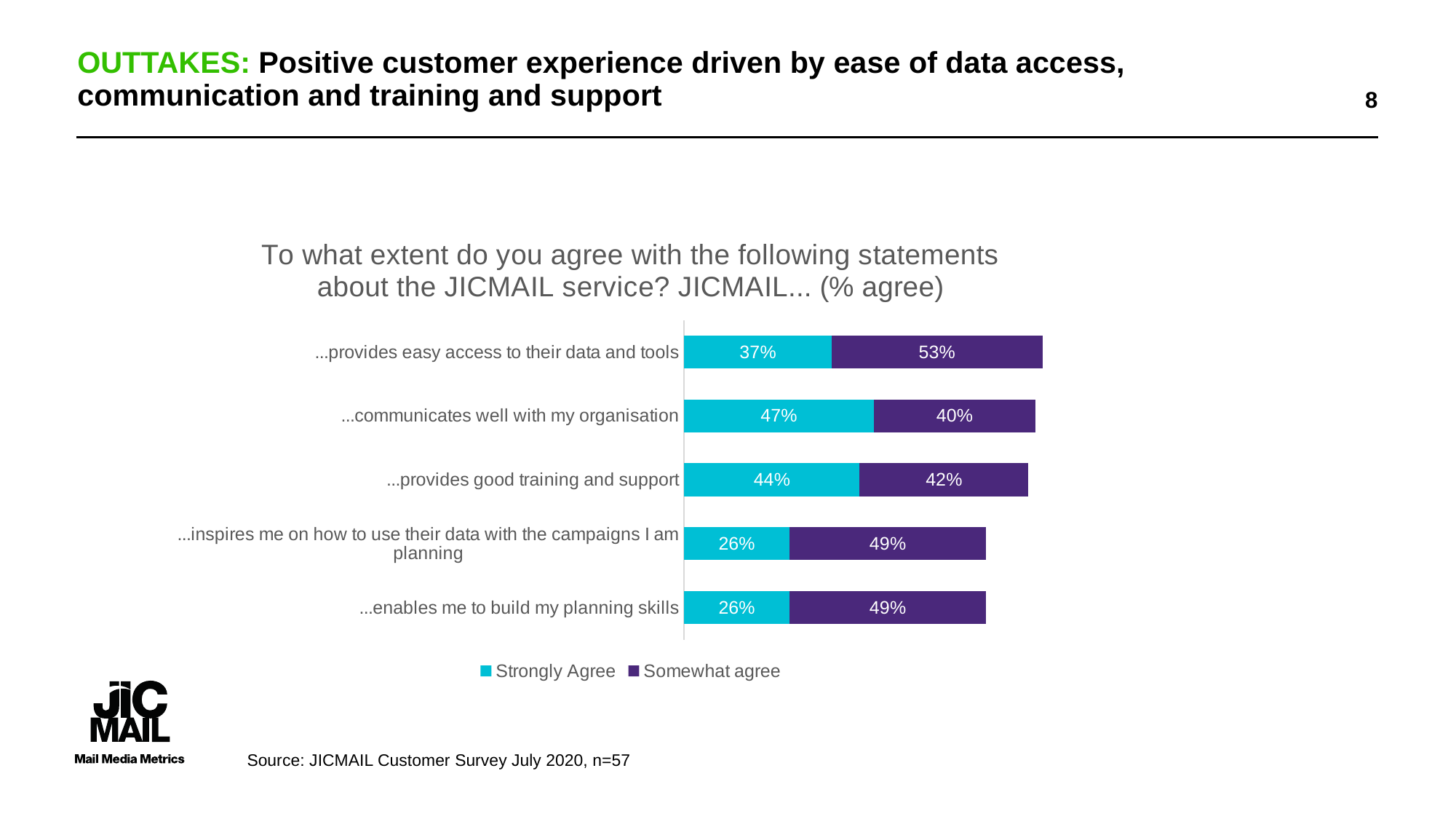
Which is larger: the Strongly Agree percentage for 'provides good training and support' or for 'provides easy access to their data and tools'? ...provides good training and support Which statement has the highest Strongly Agree percentage? ...communicates well with my organisation What is the total percentage agreeing (Strongly Agree plus Somewhat agree) that JICMAIL enables me to build my planning skills? 75% What is the total percentage agreeing (Strongly Agree plus Somewhat agree) that JICMAIL provides easy access to their data and tools? 90% How many statements are shown in the chart? 5 What is the difference between the Strongly Agree percentages for 'communicates well with my organisation' and 'enables me to build my planning skills'? 21 percentage points How many series does the legend list? 2 Which statement has the highest Somewhat agree percentage? ...provides easy access to their data and tools What percentage strongly agree that JICMAIL provides good training and support? 44% What percentage strongly agree that JICMAIL provides easy access to their data and tools? 37% What type of chart is shown on the slide? Stacked bar chart What percentage somewhat agree that JICMAIL communicates well with my organisation? 40%